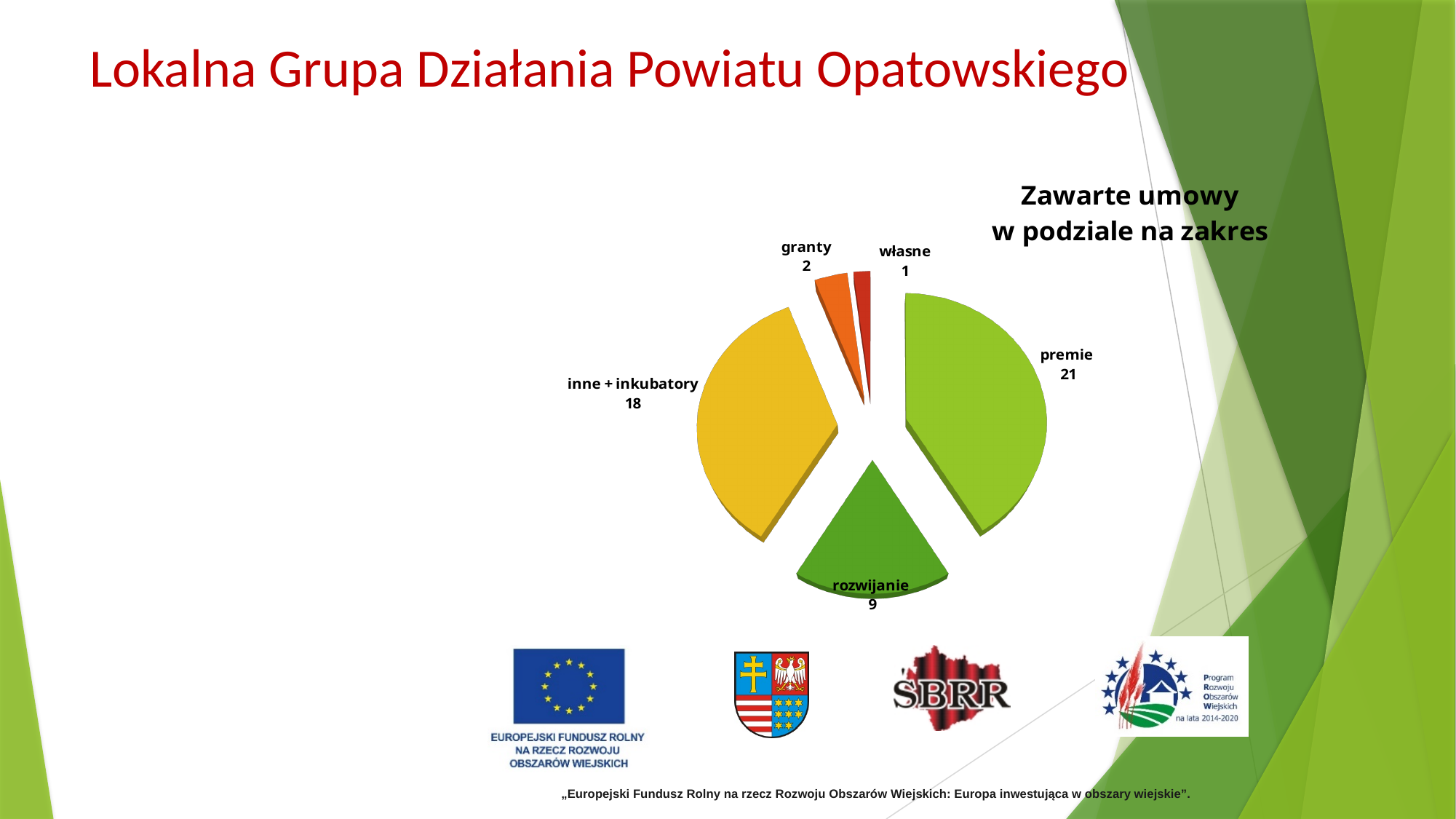
What type of chart is shown on the slide? pie chart What is the value for "rozwijanie"? 9 What is the value for "inne + inkubatory"? 18 What is the value for "granty"? 2 What is the title of the chart? Zawarte umowy w podziale na zakres Which is larger, the value for "rozwijanie" or the value for "granty"? rozwijanie Which category has the smallest slice? własne What is the value for "premie"? 21 How many slices does the pie chart have? 5 What is the total of all slices in the pie chart? 51 What is the difference between the values for "premie" and "inne + inkubatory"? 3 Which category has the largest slice? premie